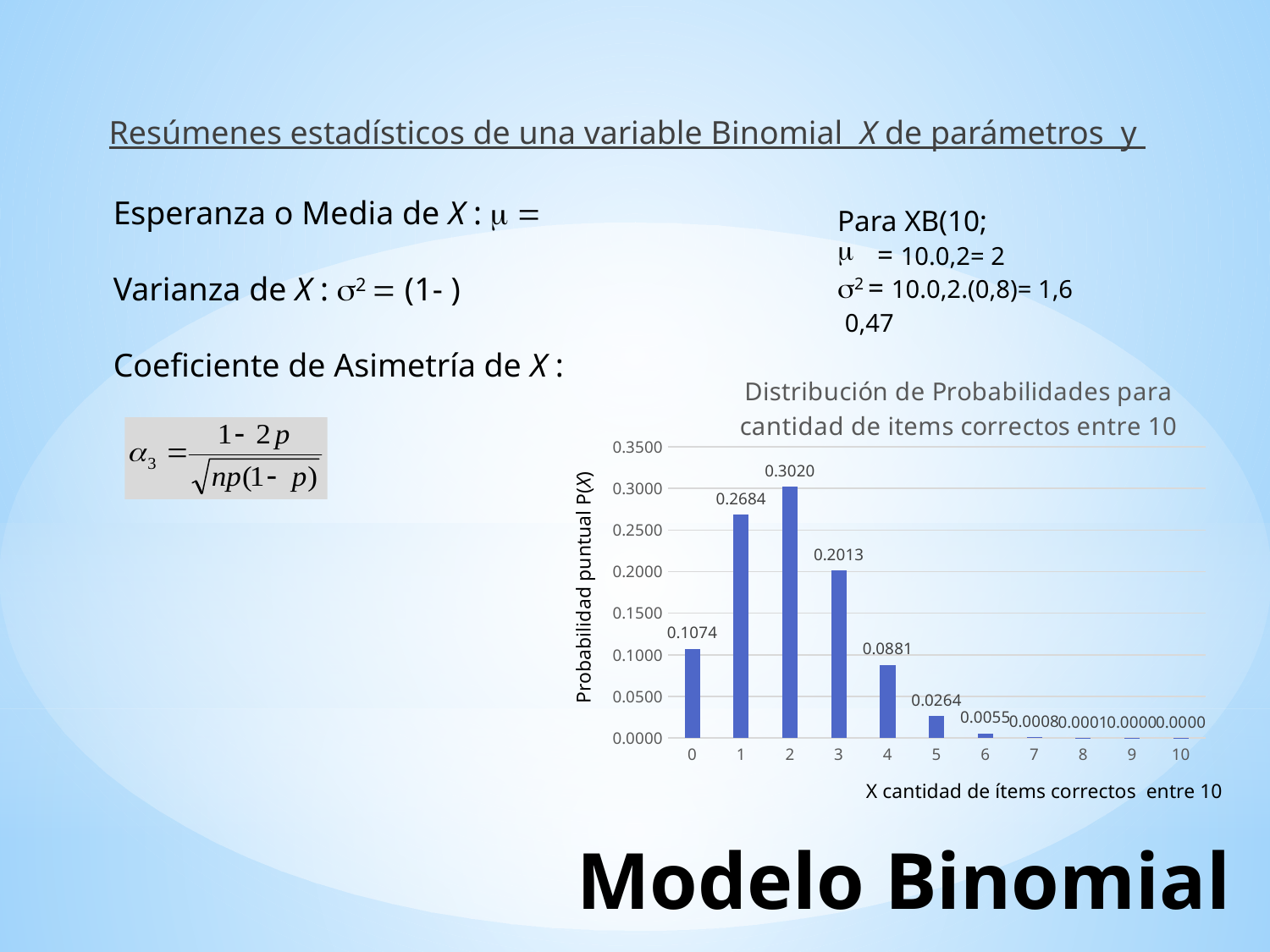
What is the probability value shown for X = 5 in the chart? 0.0264 What is the probability value shown for X = 2 in the chart? 0.3020 Do the probabilities rise or fall as X goes from 2 to 6? fall Which value of X has the highest probability in the chart? 2 What is the title of the vertical axis of the chart? Probabilidad puntual P(X) What is the probability value shown for X = 0 in the chart? 0.1074 Which has a larger probability, X = 3 or X = 4? X = 3 What is the difference between the probability for X = 0 and the probability for X = 4? 0.0193 Is the probability for X = 1 greater or less than 0.2500? greater What is the difference between the probability for X = 2 and the probability for X = 1? 0.0336 How many values of X are plotted on the x axis of the chart? 11 What kind of chart is shown on the slide? bar chart